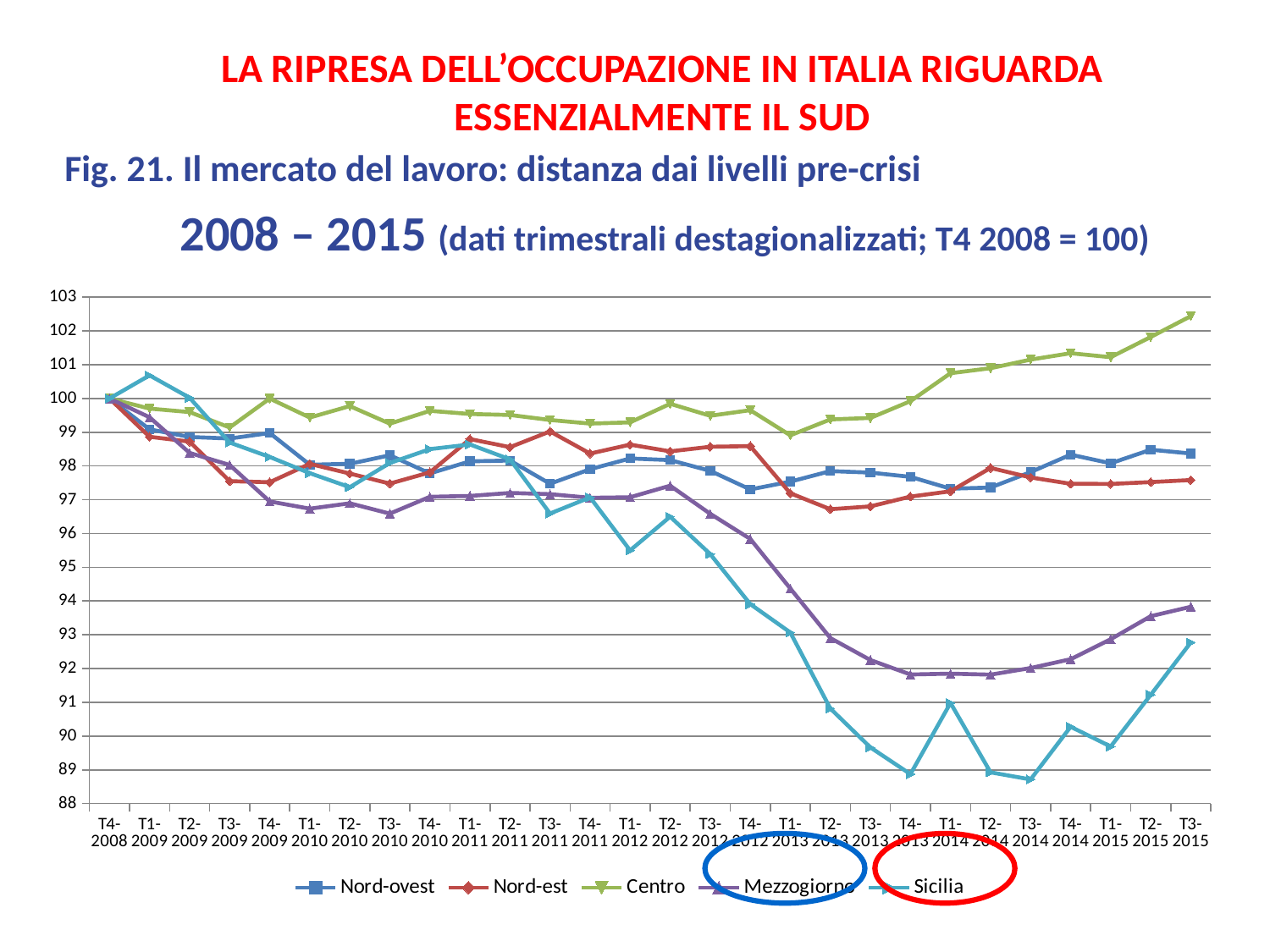
Which series has the highest value at T3-2015? Centro Which two legend entries are circled on the slide? Mezzogiorno and Sicilia How many quarterly points are plotted along the x axis? 28 Is the value for Centro at T3-2015 greater or less than 101? greater Which series has the lowest value at T4-2013? Sicilia Does the Centro series rise or fall from T2-2013 to T3-2015? rise At T2-2013, which is larger: the value for Mezzogiorno or the value for Sicilia? Mezzogiorno Is the value for Sicilia at T4-2013 greater or less than 90? less What is the value of every series at T4-2008? 100 What type of chart is shown on the slide? line chart Which series has the highest value at T1-2009? Sicilia How many series does the legend list? 5